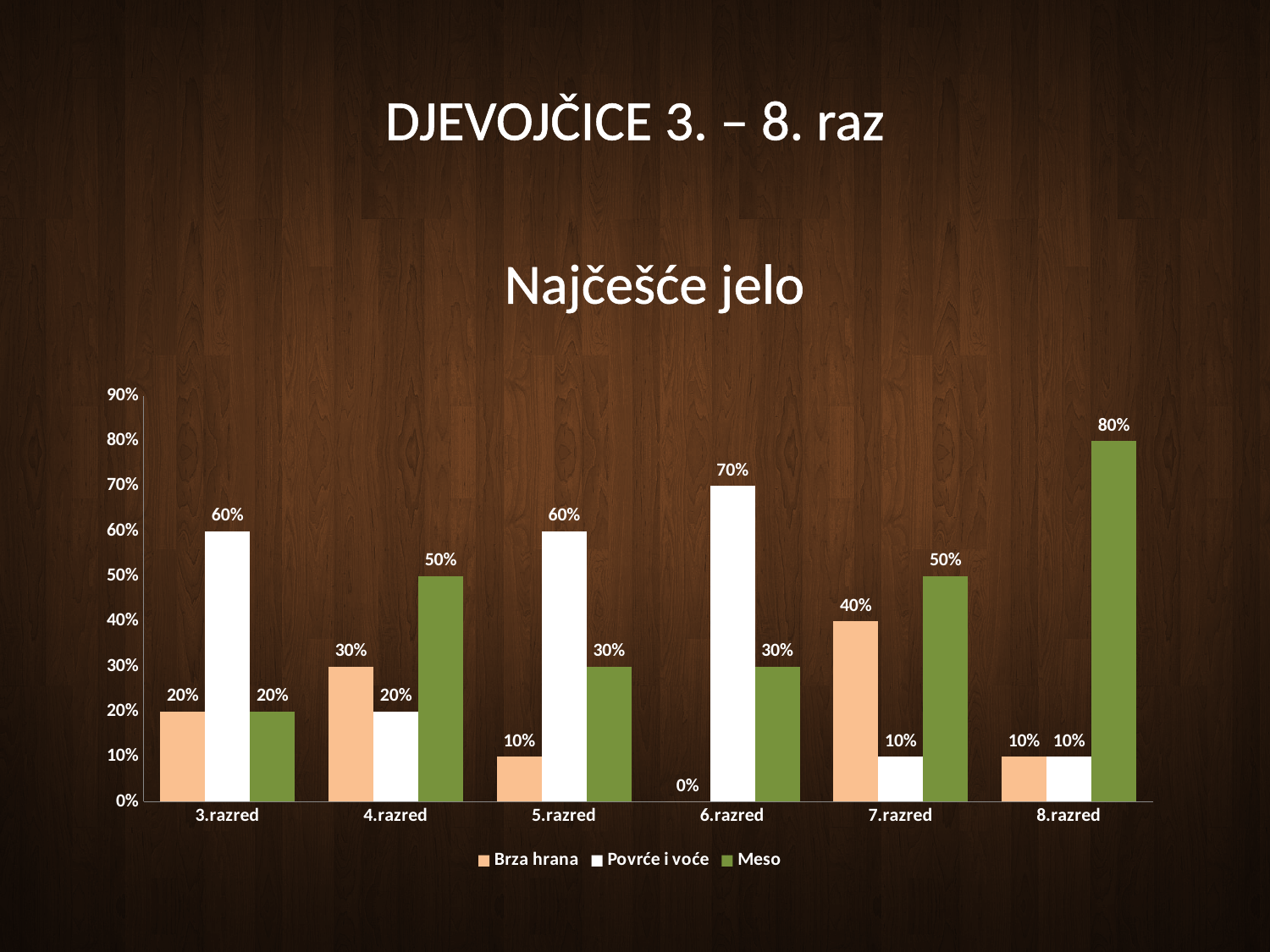
What is the title of the chart? Najčešće jelo What is the value for Brza hrana in 7.razred? 40% In which category does Meso reach its highest value? 8.razred How many categories are shown on the x axis? 6 What is the value for Povrće i voće in 6.razred? 70% What kind of chart is shown on the slide? Bar chart In which category is Brza hrana lowest? 6.razred What is the value for Brza hrana in 6.razred? 0% What is the difference between Povrće i voće and Brza hrana in 3.razred? 40% How many series does the legend list? 3 What is the value for Meso in 8.razred? 80% Which is larger in 4.razred, Brza hrana or Meso? Meso